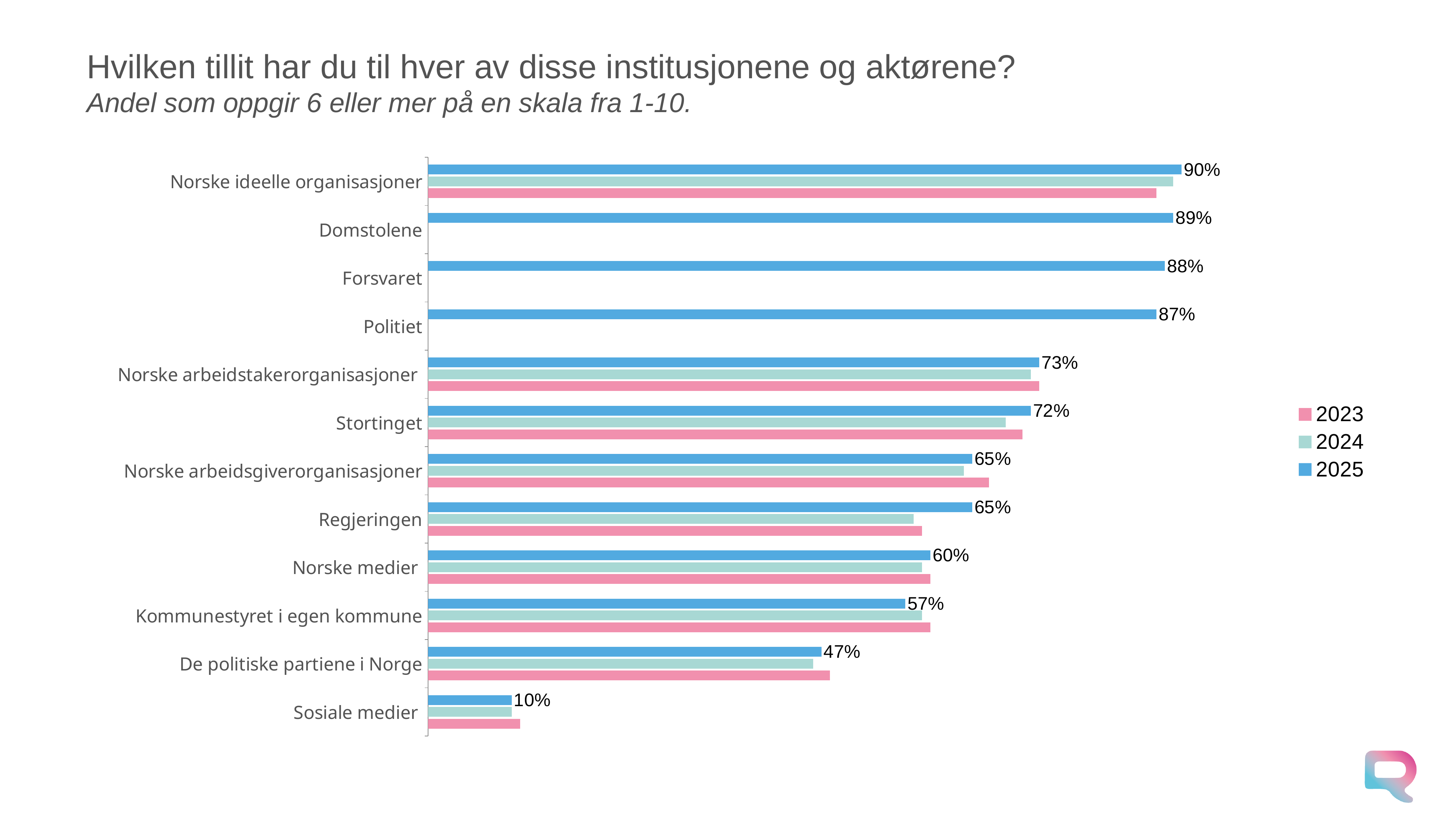
How many categories are shown on the chart? 12 What is the 2025 value for Kommunestyret i egen kommune? 57% What is the 2025 value for Sosiale medier? 10% How many series does the legend list? 3 For Regjeringen, which year has the larger value, 2024 or 2025? 2025 What is the 2025 value for Norske ideelle organisasjoner? 90% What is the difference between the 2025 values for Norske ideelle organisasjoner and Sosiale medier? 80 percentage points Which category has the lowest 2025 value? Sosiale medier For Sosiale medier, which year has the larger value, 2023 or 2025? 2023 What is the 2025 value for Stortinget? 72% Which category has the highest 2025 value? Norske ideelle organisasjoner What is the difference between the 2025 values for Norske arbeidstakerorganisasjoner and De politiske partiene i Norge? 26 percentage points